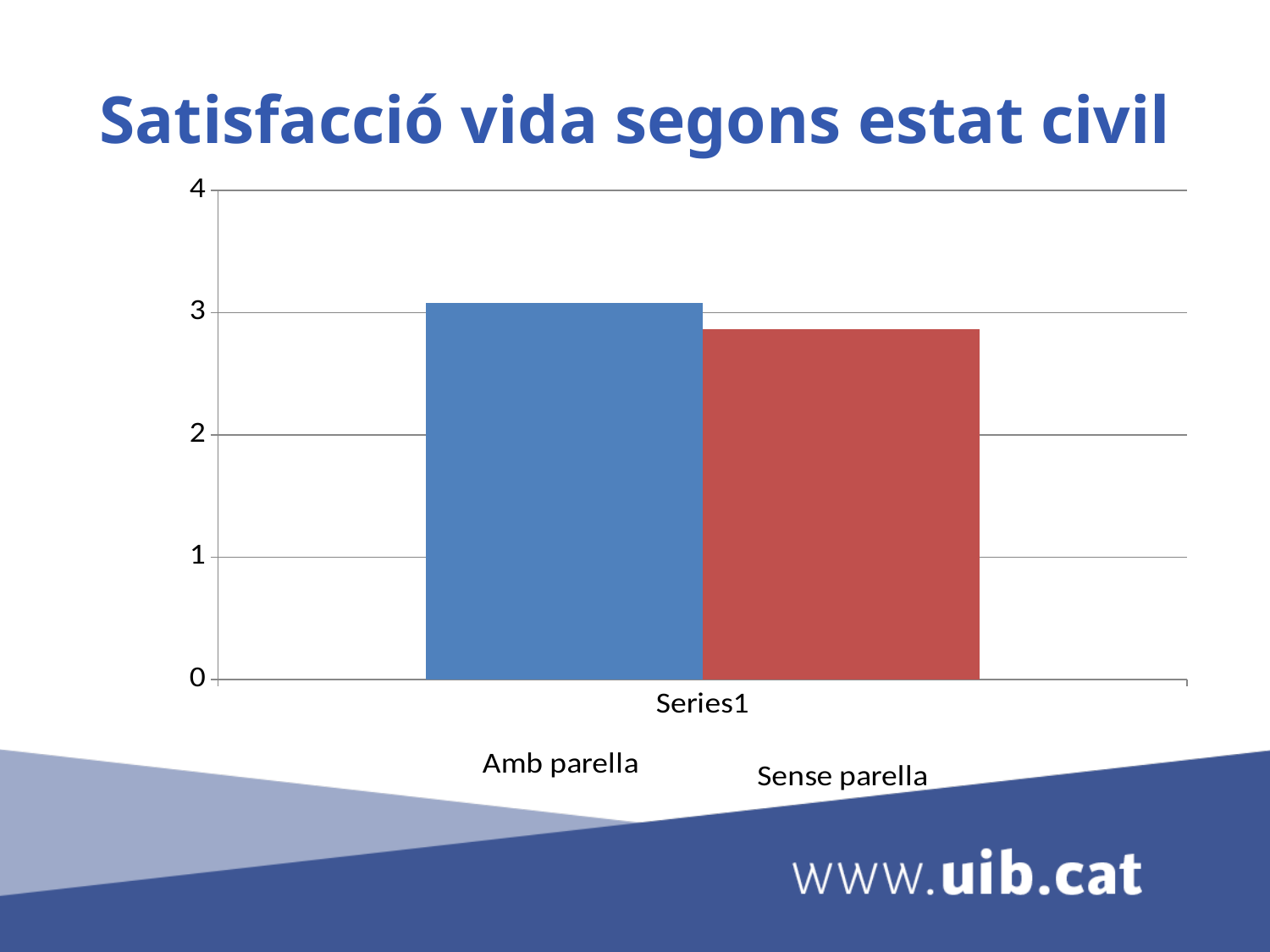
Is the value for Amb parella greater or less than 3? greater What kind of chart is shown on the slide? bar chart How many bars are plotted in the chart? 2 Which series has the highest bar? Amb parella Is the value for Sense parella greater or less than 3? less Is the value for Sense parella greater or less than 2? greater What colour is the bar for Sense parella? red Which series has the lowest bar? Sense parella Which is larger, the value for Amb parella or the value for Sense parella? Amb parella How many series does the legend list? 2 What is the title of the chart? Satisfacció vida segons estat civil What is the highest value shown on the vertical axis? 4